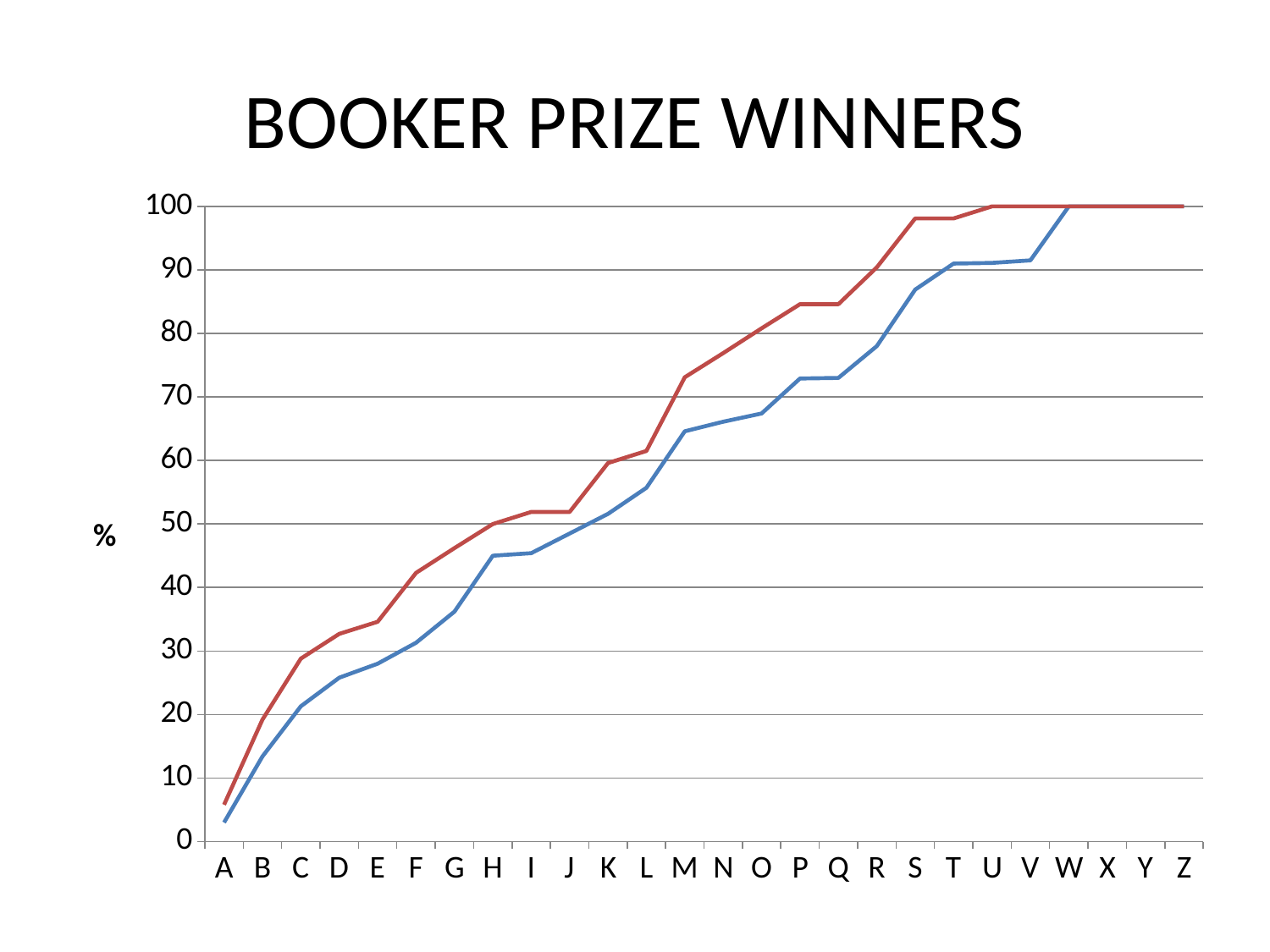
Is the value of the blue line at P greater or less than 70? greater Is the value of the blue line at S greater or less than 90? less Is the value of the red line at M greater or less than 70? greater Do the values of the lines rise or fall from A to Z? rise At M, which line has the higher value, the red line or the blue line? the red line What value does the red line reach at Z? 100 How many categories are shown on the x axis? 26 What is the title of the chart? BOOKER PRIZE WINNERS How many lines are plotted on the chart? 2 What kind of chart is shown on the slide? line chart What value does the blue line reach at W? 100